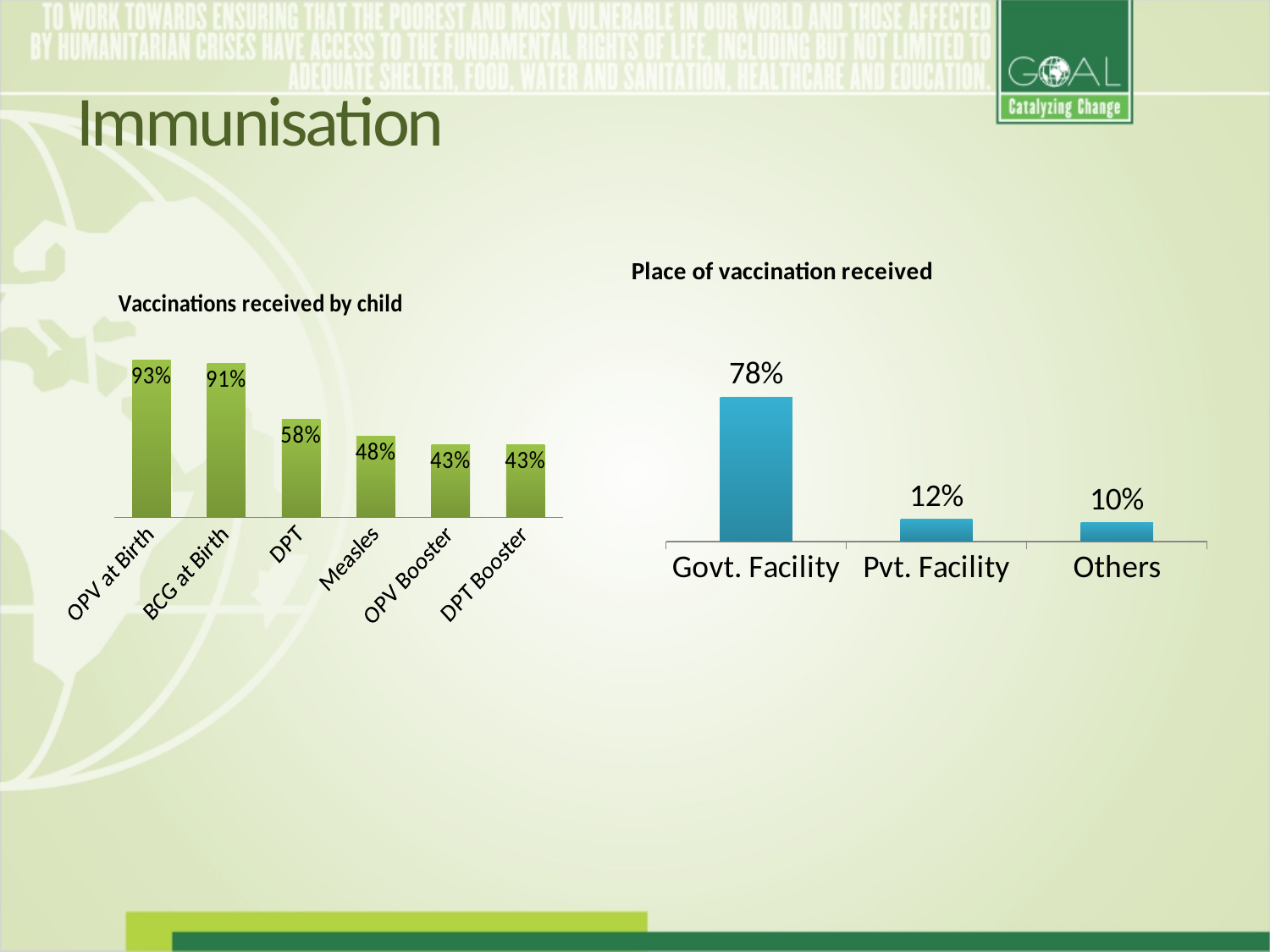
In the 'Place of vaccination received' chart, what percentage received vaccination at a Govt. Facility? 78% In the 'Vaccinations received by child' chart, do the values rise or fall from left to right? fall In the 'Place of vaccination received' chart, which place has the lowest value? Others In the 'Vaccinations received by child' chart, what is the difference between BCG at Birth and DPT? 33% What colour are the bars in the 'Vaccinations received by child' chart? green In the 'Vaccinations received by child' chart, which vaccination has the highest value? OPV at Birth In the 'Place of vaccination received' chart, what is the difference between Govt. Facility and Pvt. Facility? 66% What type of chart is the 'Place of vaccination received' chart? bar chart In the 'Place of vaccination received' chart, which is larger: Pvt. Facility or Others? Pvt. Facility In the 'Vaccinations received by child' chart, what is the value for Measles? 48% In the 'Vaccinations received by child' chart, what percentage of children received OPV at Birth? 93% In the 'Vaccinations received by child' chart, how many vaccination categories are shown? 6